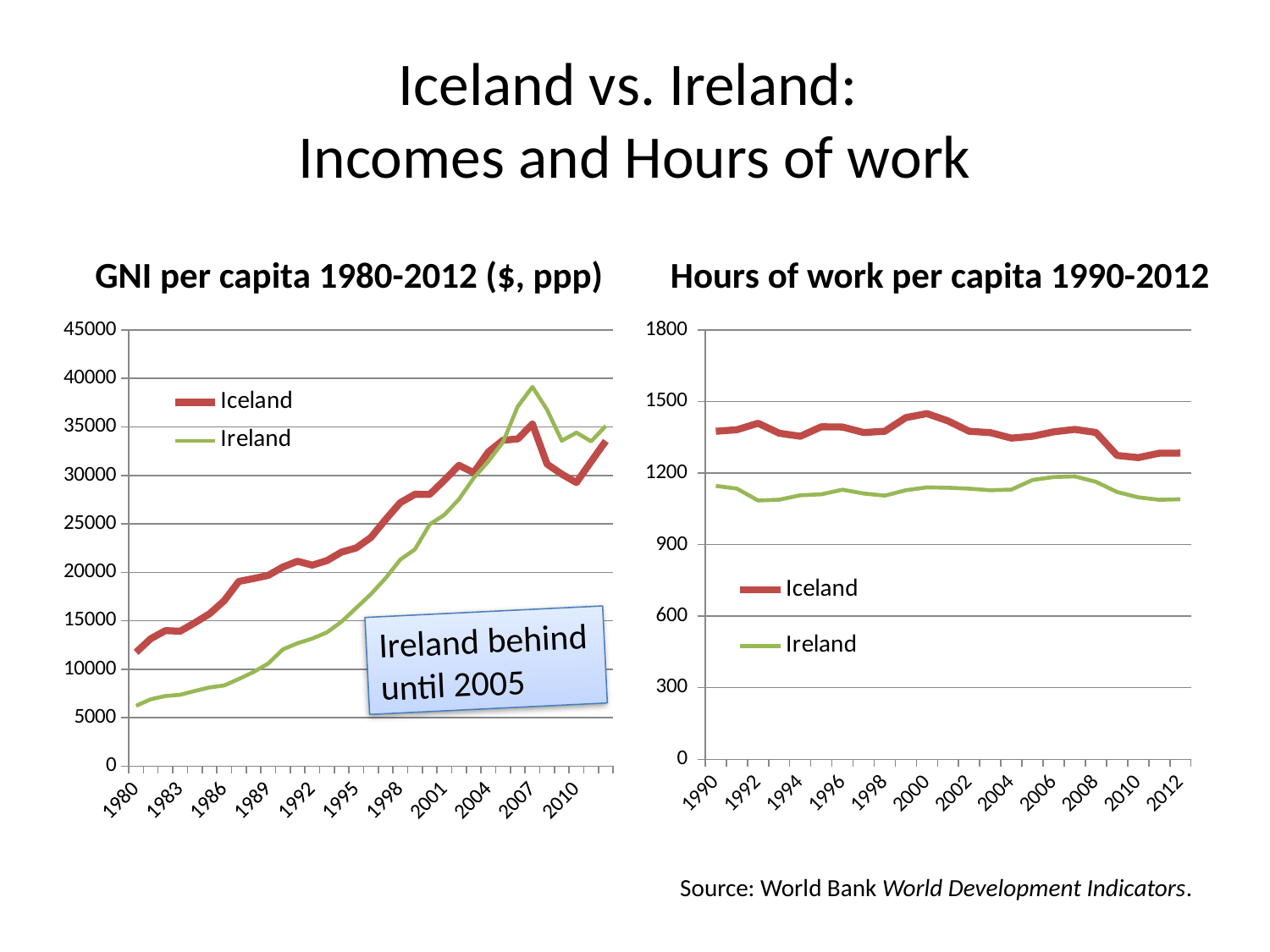
In the 'GNI per capita 1980-2012 ($, ppp)' chart, is the value for Ireland in 1980 greater or less than 10000? less How many series does the legend of the 'Hours of work per capita 1990-2012' chart list? 2 In the 'GNI per capita 1980-2012 ($, ppp)' chart, which country has the higher GNI per capita in 2007? Ireland In the 'Hours of work per capita 1990-2012' chart, which country has the higher hours of work per capita in 2000? Iceland What kind of chart is the 'Hours of work per capita 1990-2012' chart? line chart In the 'Hours of work per capita 1990-2012' chart, is the value for Ireland in 2012 greater or less than 1200? less In the 'GNI per capita 1980-2012 ($, ppp)' chart, does the Ireland line rise or fall from 1980 to 2007? rise What kind of chart is the 'GNI per capita 1980-2012 ($, ppp)' chart? line chart In the 'GNI per capita 1980-2012 ($, ppp)' chart, is the value for Iceland in 1980 greater or less than 10000? greater In the 'GNI per capita 1980-2012 ($, ppp)' chart, which country has the higher GNI per capita in 1980? Iceland How many series does the legend of the 'GNI per capita 1980-2012 ($, ppp)' chart list? 2